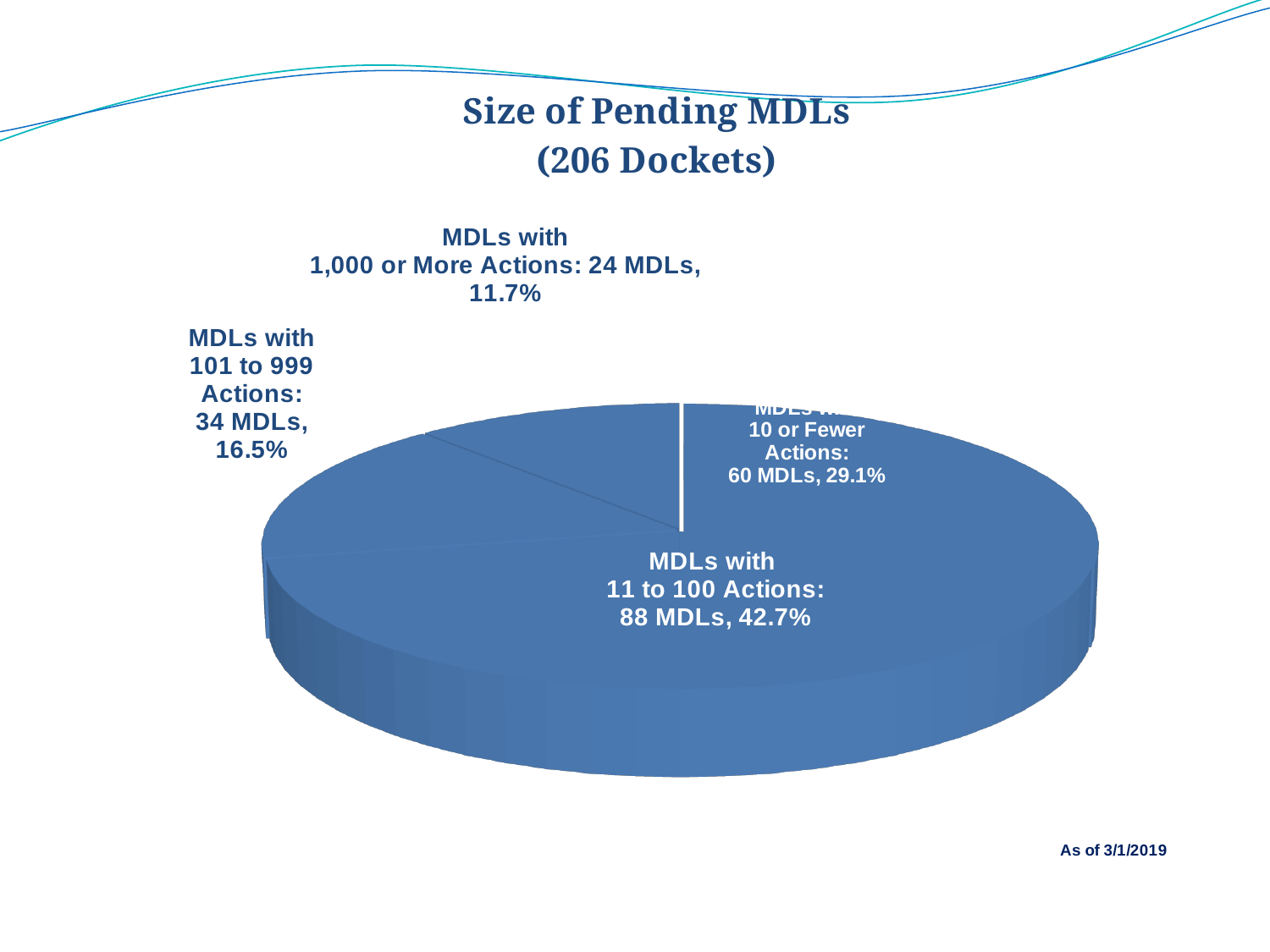
Which has more MDLs: the 101 to 999 Actions category or the 1,000 or More Actions category? MDLs with 101 to 999 Actions What share of the pie is MDLs with 10 or fewer actions? 29.1% How many slices does the pie chart have? 4 How many MDLs have 11 to 100 actions? 88 MDLs What kind of chart is shown on the slide? Pie chart Which category has the smallest slice of the pie? MDLs with 1,000 or More Actions What is the difference in the number of MDLs between the 11 to 100 Actions category and the 10 or Fewer Actions category? 28 MDLs What is the title of the chart? Size of Pending MDLs (206 Dockets) Which category has the largest slice of the pie? MDLs with 11 to 100 Actions How many MDLs have 1,000 or more actions? 24 MDLs As of what date is the chart data reported? 3/1/2019 What percentage of pending MDLs have 101 to 999 actions? 16.5%